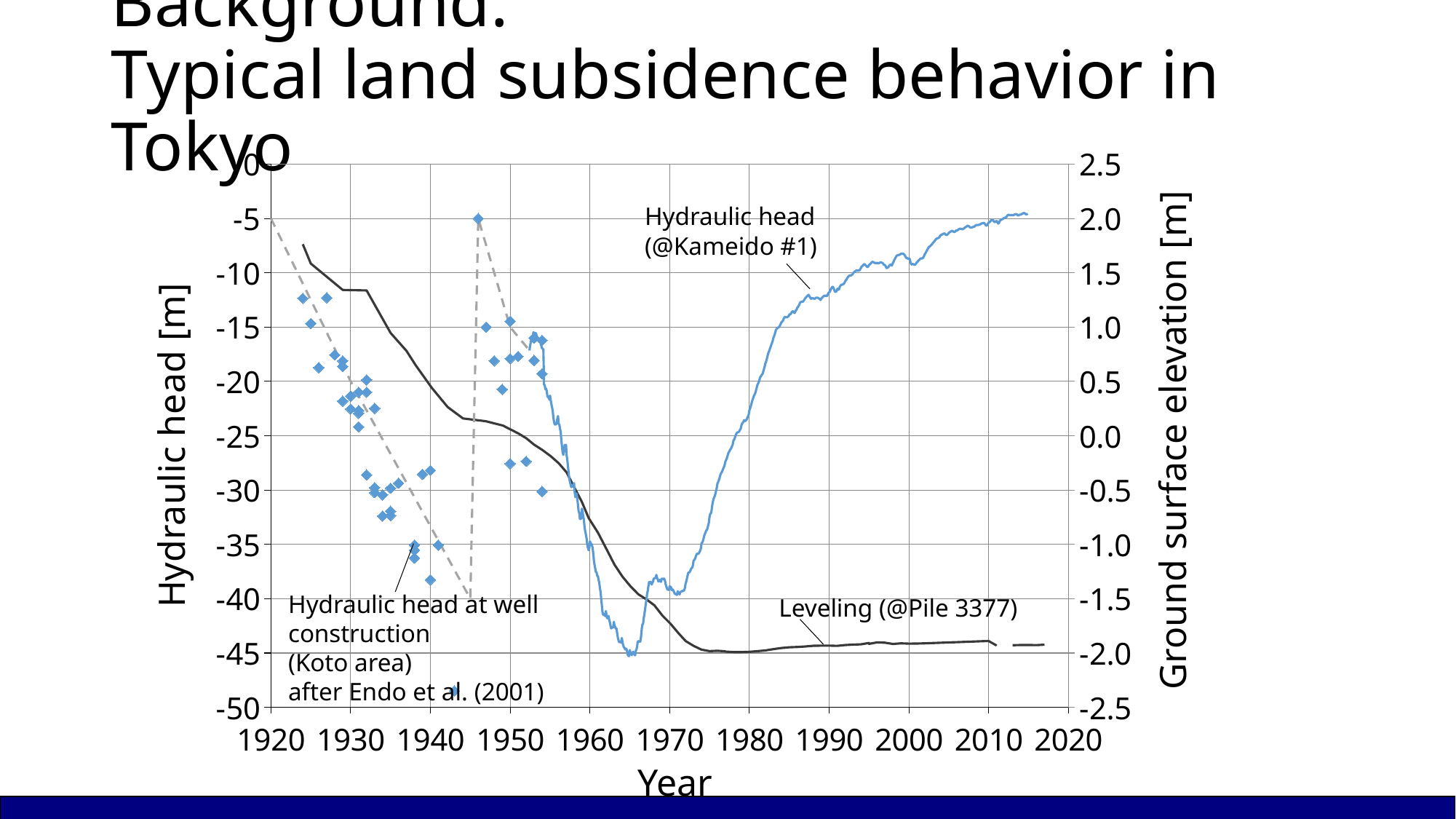
What is the label of the left vertical axis? Hydraulic head [m] Is the hydraulic head (@Kameido #1) around 2010 greater or less than -10 m? greater Is the hydraulic head (@Kameido #1) around 1965 greater or less than -40 m? less What is the lowest value shown on the left vertical axis? -50 Is the leveling (@Pile 3377) ground surface elevation around 2000 greater or less than -1.5 m? less Does the leveling (@Pile 3377) ground surface elevation rise or fall between 1925 and 1975? fall What is the label of the right vertical axis? Ground surface elevation [m] What kind of chart is shown on the slide? line chart Which is larger: the hydraulic head (@Kameido #1) around 1965 or around 2010? around 2010 Does the hydraulic head (@Kameido #1) rise or fall between 1965 and 2015? rise